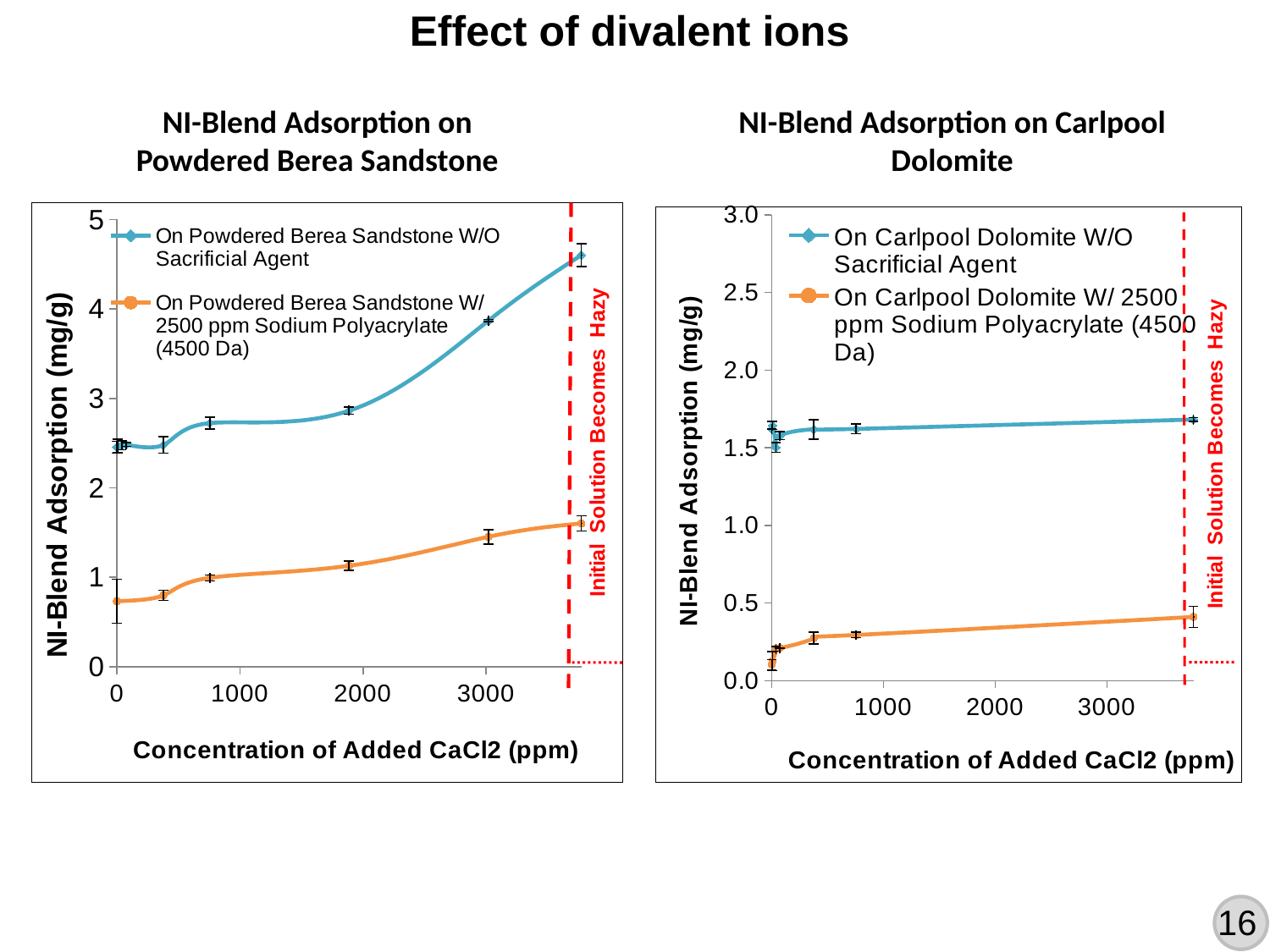
In the 'NI-Blend Adsorption on Powdered Berea Sandstone' chart, which series has the higher adsorption at about 3000 ppm? On Powdered Berea Sandstone W/O Sacrificial Agent In the 'NI-Blend Adsorption on Carlpool Dolomite' chart, is the value of the 'On Carlpool Dolomite W/ 2500 ppm Sodium Polyacrylate (4500 Da)' series at its highest concentration point greater or less than 0.5? less In the 'NI-Blend Adsorption on Powdered Berea Sandstone' chart, is the value of the 'On Powdered Berea Sandstone W/O Sacrificial Agent' series at about 3000 ppm greater or less than 3? greater In the 'NI-Blend Adsorption on Carlpool Dolomite' chart, which series has the higher adsorption across the plotted concentrations? On Carlpool Dolomite W/O Sacrificial Agent What is the x-axis label of the 'NI-Blend Adsorption on Carlpool Dolomite' chart? Concentration of Added CaCl2 (ppm) In the 'NI-Blend Adsorption on Powdered Berea Sandstone' chart, does the 'On Powdered Berea Sandstone W/O Sacrificial Agent' series rise or fall as the concentration of added CaCl2 increases? Rise In the 'NI-Blend Adsorption on Powdered Berea Sandstone' chart, is the value of the 'On Powdered Berea Sandstone W/ 2500 ppm Sodium Polyacrylate (4500 Da)' series at about 2000 ppm greater or less than 2? less How many series does the legend of the 'NI-Blend Adsorption on Powdered Berea Sandstone' chart list? 2 How many series does the legend of the 'NI-Blend Adsorption on Carlpool Dolomite' chart list? 2 What kind of chart is the 'NI-Blend Adsorption on Powdered Berea Sandstone' chart? Line chart What does the red dashed vertical line in each chart indicate? Initial Solution Becomes Hazy